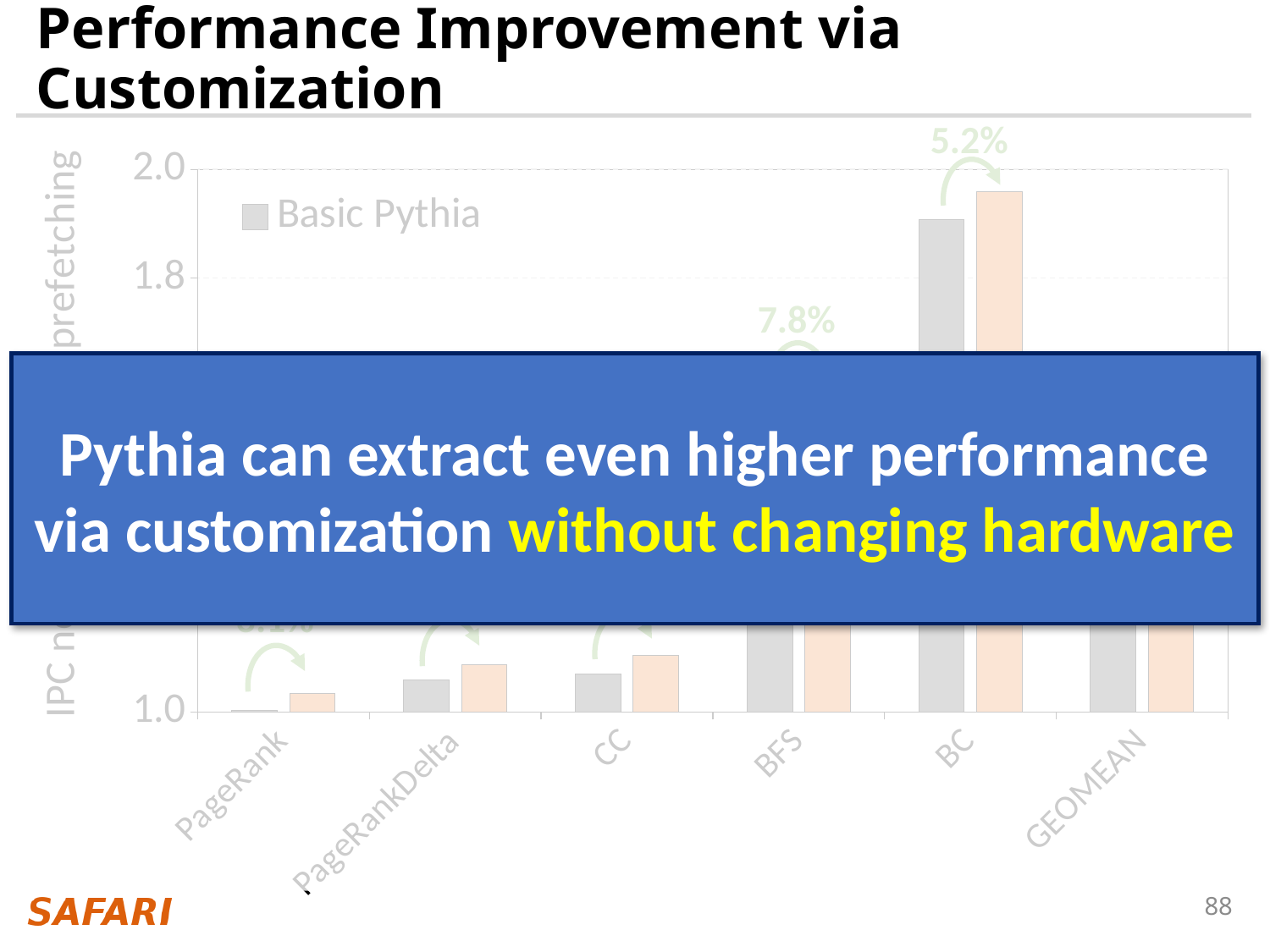
What is the highest tick value shown on the y axis of the chart? 2.0 What is the first series listed in the chart legend? Basic Pythia What kind of chart is shown on the slide? bar chart Is the value of the orange (customized) bar for BC greater or less than 2.0? less Is the Basic Pythia value for PageRank greater or less than 1.8? less What percentage improvement is annotated above the BFS bars? 7.8% Which category has the lowest Basic Pythia bar in the chart? PageRank Which category has the highest bars in the chart? BC Which has a larger Basic Pythia value, BC or PageRank? BC Is the Basic Pythia value for BC greater or less than 1.8? greater How many categories are shown on the x axis of the chart? 6 What percentage improvement is annotated above the BC bars? 5.2%